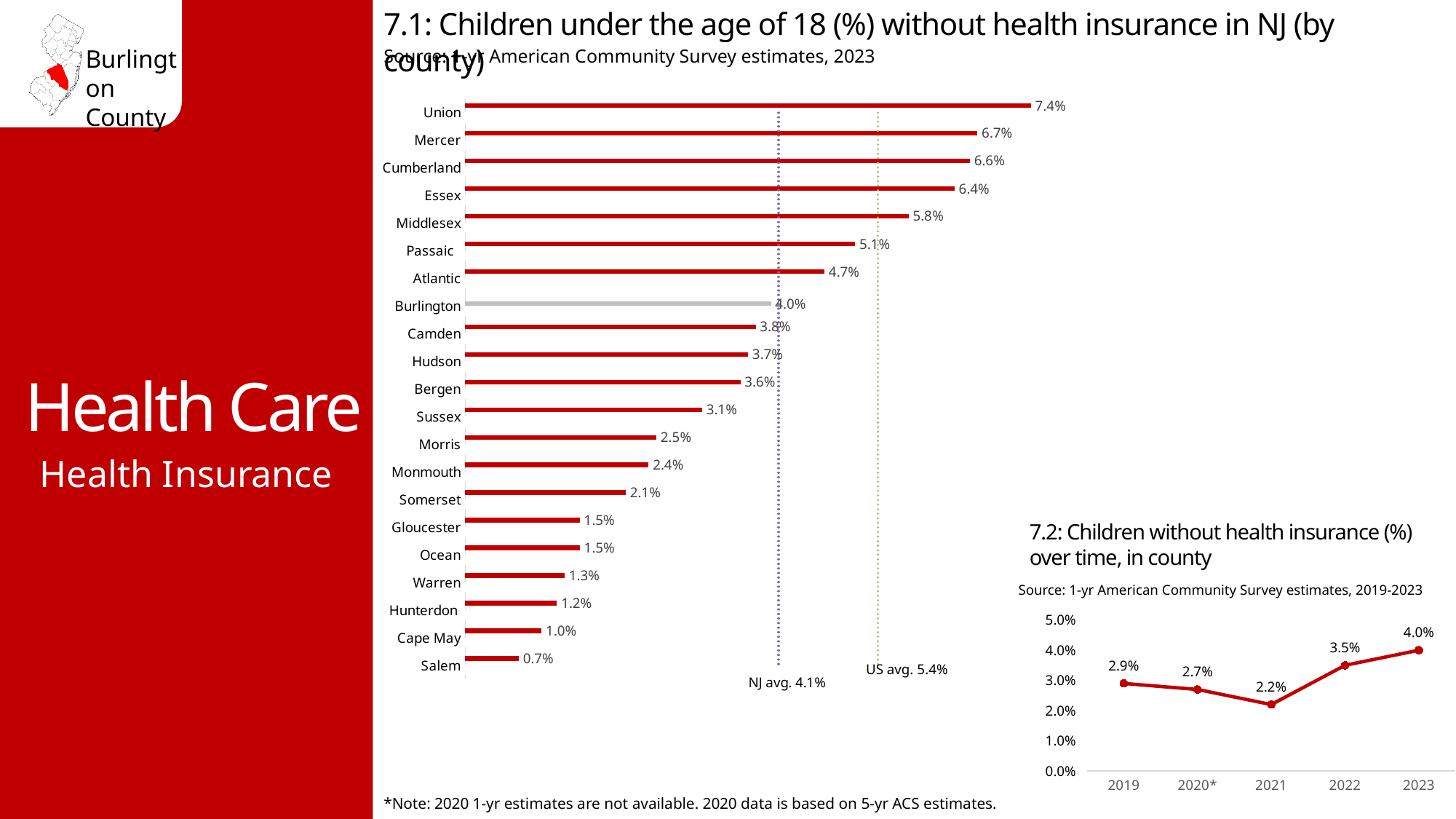
In chart 7.1 (children under 18 without health insurance by county), what is the value for Burlington? 4.0% In chart 7.1, which county has a higher value, Mercer or Essex? Mercer In chart 7.1, how many counties are shown? 21 In chart 7.2, what is the difference between the 2023 and 2019 values? 1.1% In chart 7.1, which county has the lowest percentage of children without health insurance? Salem What kind of chart is chart 7.2? Line chart In chart 7.1, what is the difference between the values for Union and Salem? 6.7% In chart 7.2, which year has the highest value? 2023 What kind of chart is chart 7.1? Bar chart In chart 7.1, what is the NJ average shown by the dotted reference line? 4.1% In chart 7.2 (children without health insurance over time, in county), what is the value for 2021? 2.2% In chart 7.1, which county has the highest percentage of children without health insurance? Union